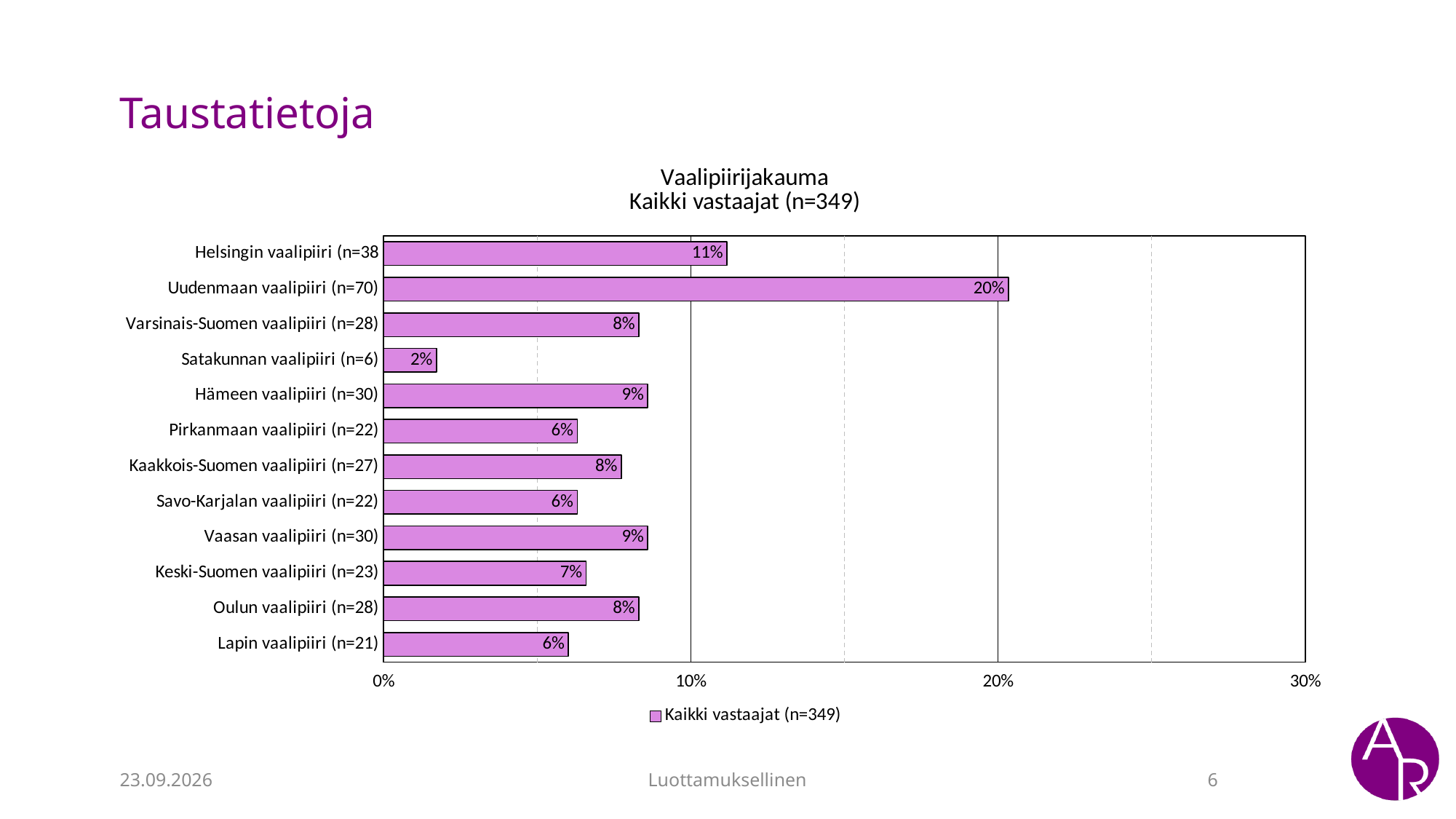
What kind of chart is shown on the slide? Bar chart Which is larger, the value for Hämeen vaalipiiri (n=30) or the value for Pirkanmaan vaalipiiri (n=22)? Hämeen vaalipiiri (n=30) What is the value for Keski-Suomen vaalipiiri (n=23)? 7% What is the difference between the values for Uudenmaan vaalipiiri (n=70) and Helsingin vaalipiiri (n=38)? 9% Is the value for Uudenmaan vaalipiiri (n=70) greater or less than 10%? greater What is the legend entry of the chart? Kaikki vastaajat (n=349) What is the value for Helsingin vaalipiiri (n=38)? 11% What is the value for Satakunnan vaalipiiri (n=6)? 2% How many categories are shown in the chart? 12 Which category has the lowest value? Satakunnan vaalipiiri (n=6) What is the value for Uudenmaan vaalipiiri (n=70)? 20% Which category has the highest value? Uudenmaan vaalipiiri (n=70)